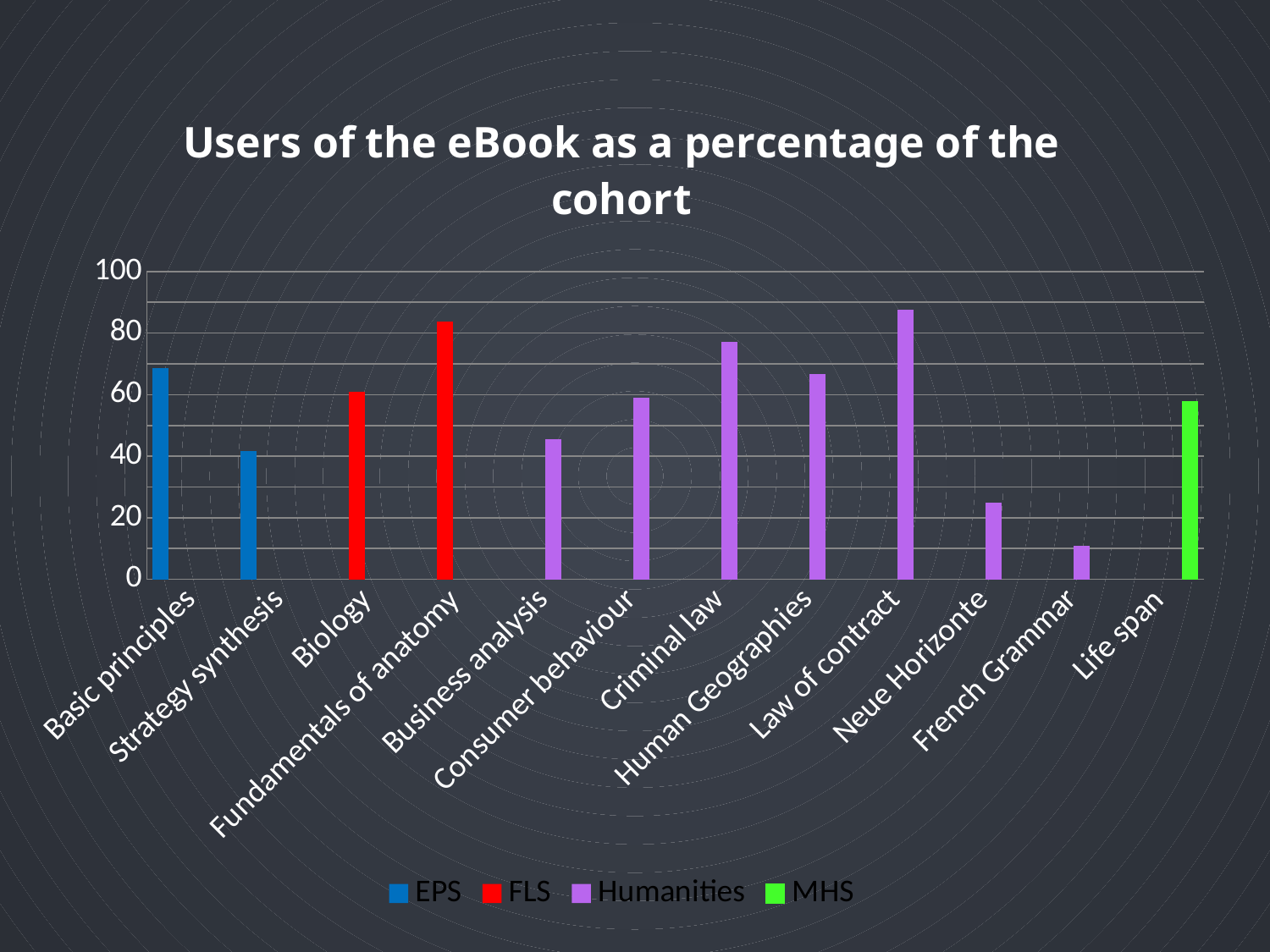
Is the value for Basic principles greater or less than 60? greater Is the value for Neue Horizonte greater or less than 40? less Which series is shown in green in the legend? MHS What is the title of the chart? Users of the eBook as a percentage of the cohort Is the value for Law of contract greater or less than 80? greater What kind of chart is shown on the slide? bar chart Which category has the lowest value? French Grammar Which category has the highest value? Law of contract How many series does the legend list? 4 Which is larger, the value for Criminal law or the value for Human Geographies? Criminal law How many categories are shown along the x axis? 12